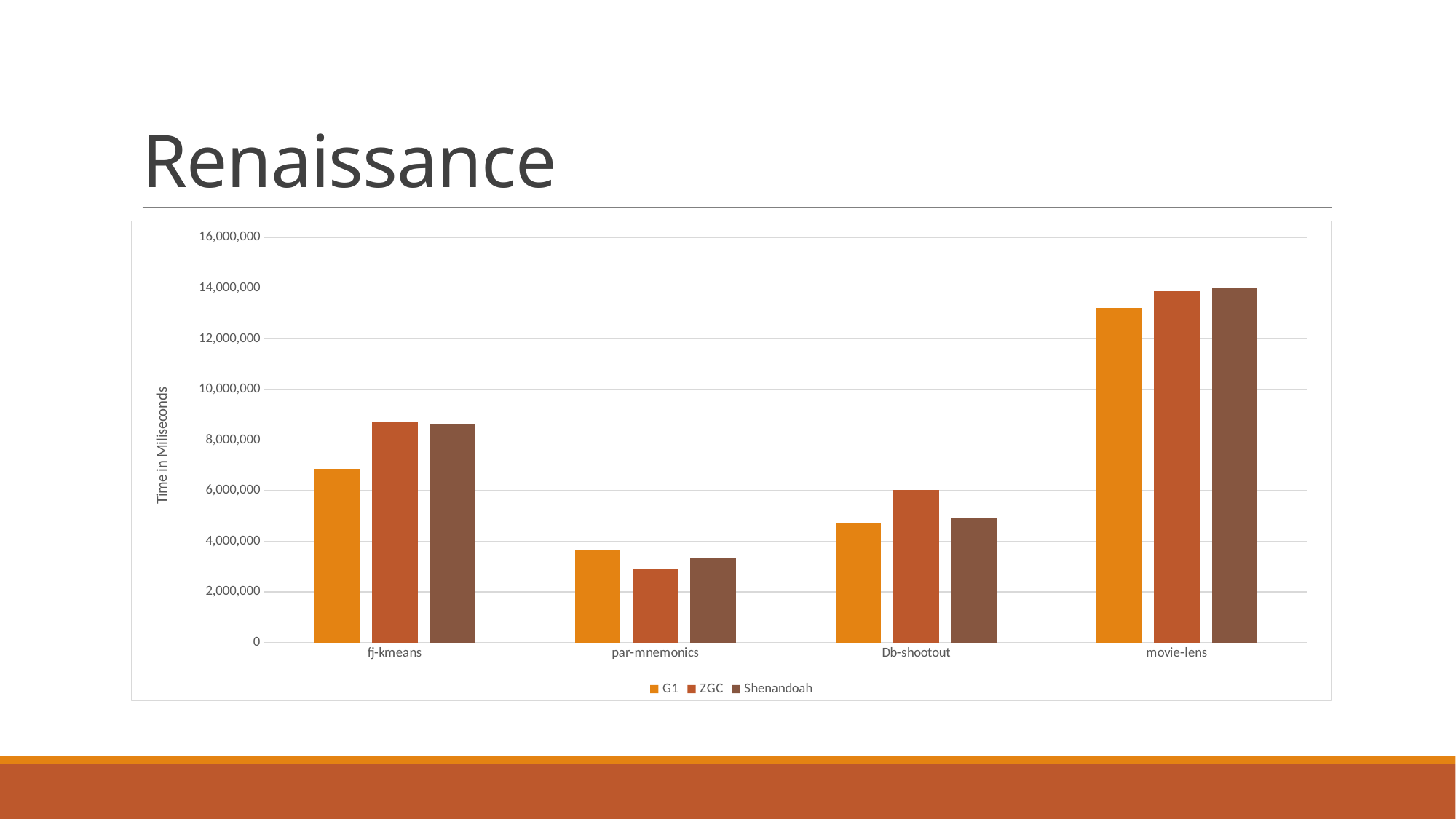
Is the ZGC value for par-mnemonics greater or less than 4,000,000? less What is the title of the slide containing the chart? Renaissance What kind of chart is shown on the slide? bar chart Is the G1 value for fj-kmeans greater or less than 6,000,000? greater How many benchmark categories are shown on the x axis? 4 Which benchmark has the lowest ZGC value? par-mnemonics What is the label of the y axis? Time in Miliseconds Is the Shenandoah value for movie-lens greater or less than 12,000,000? greater For Db-shootout, which is larger, the G1 value or the ZGC value? ZGC For par-mnemonics, which is larger, the G1 value or the Shenandoah value? G1 Which benchmark has the highest G1 value? movie-lens How many series does the legend list? 3